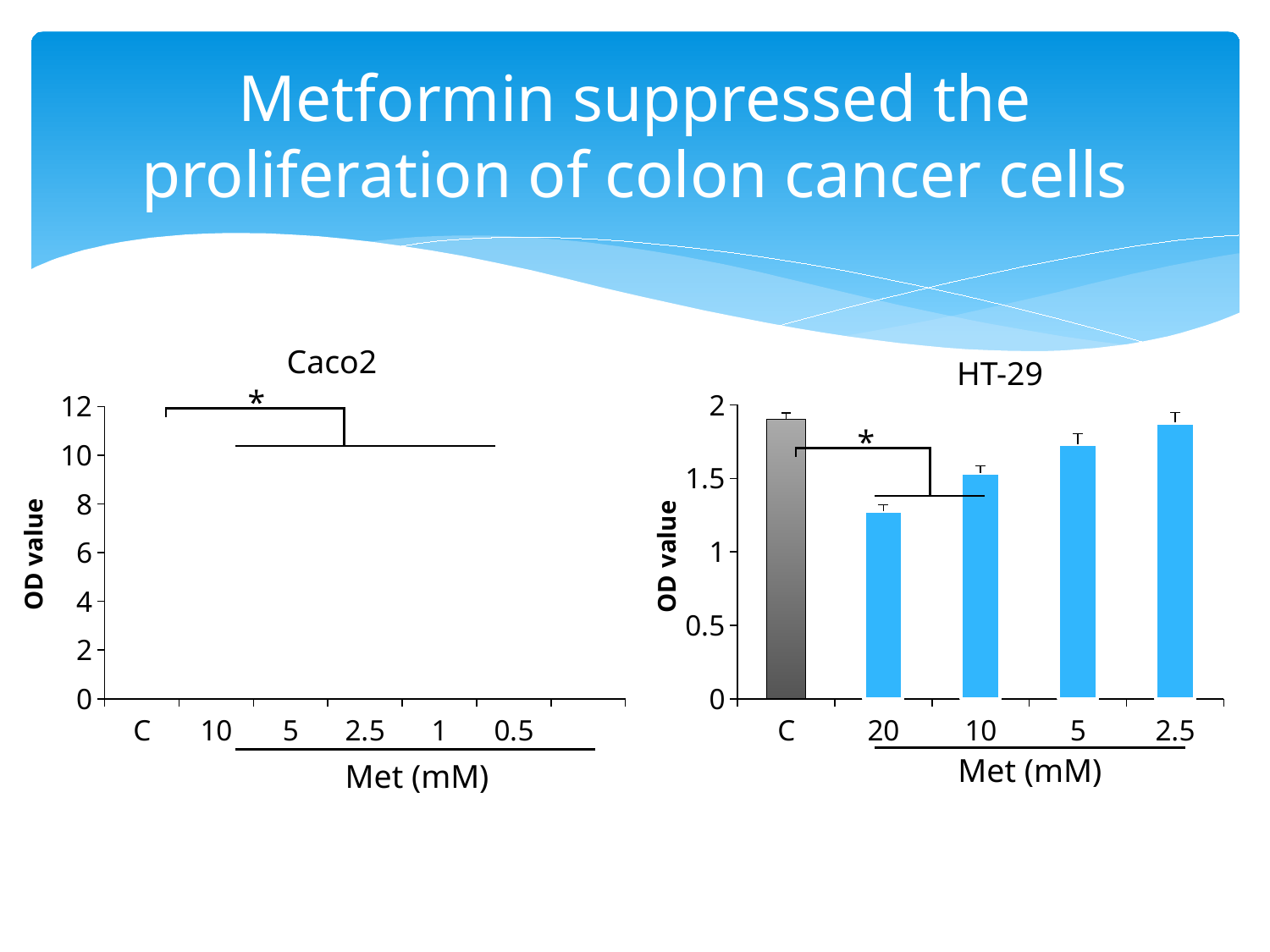
In the HT-29 chart, is the OD value for C greater or less than 1.5? greater In the HT-29 chart, do the OD values rise or fall going from 20 mM to 2.5 mM Met along the x axis? rise In the HT-29 chart, what colour is the bar for C? grey What kind of chart is the HT-29 chart? bar chart What is the y-axis label of the HT-29 chart? OD value In the HT-29 chart, which category has the lowest OD value? 20 In the HT-29 chart, is the OD value for 5 mM Met greater or less than 1.5? greater In the HT-29 chart, which has a larger OD value, 10 mM Met or 5 mM Met? 5 mM Met In the HT-29 chart, which has a larger OD value, C or 20 mM Met? C In the HT-29 chart, how many bars are plotted? 5 In the HT-29 chart, which category has the highest OD value? C In the HT-29 chart, is the OD value for 20 mM Met greater or less than 1.5? less